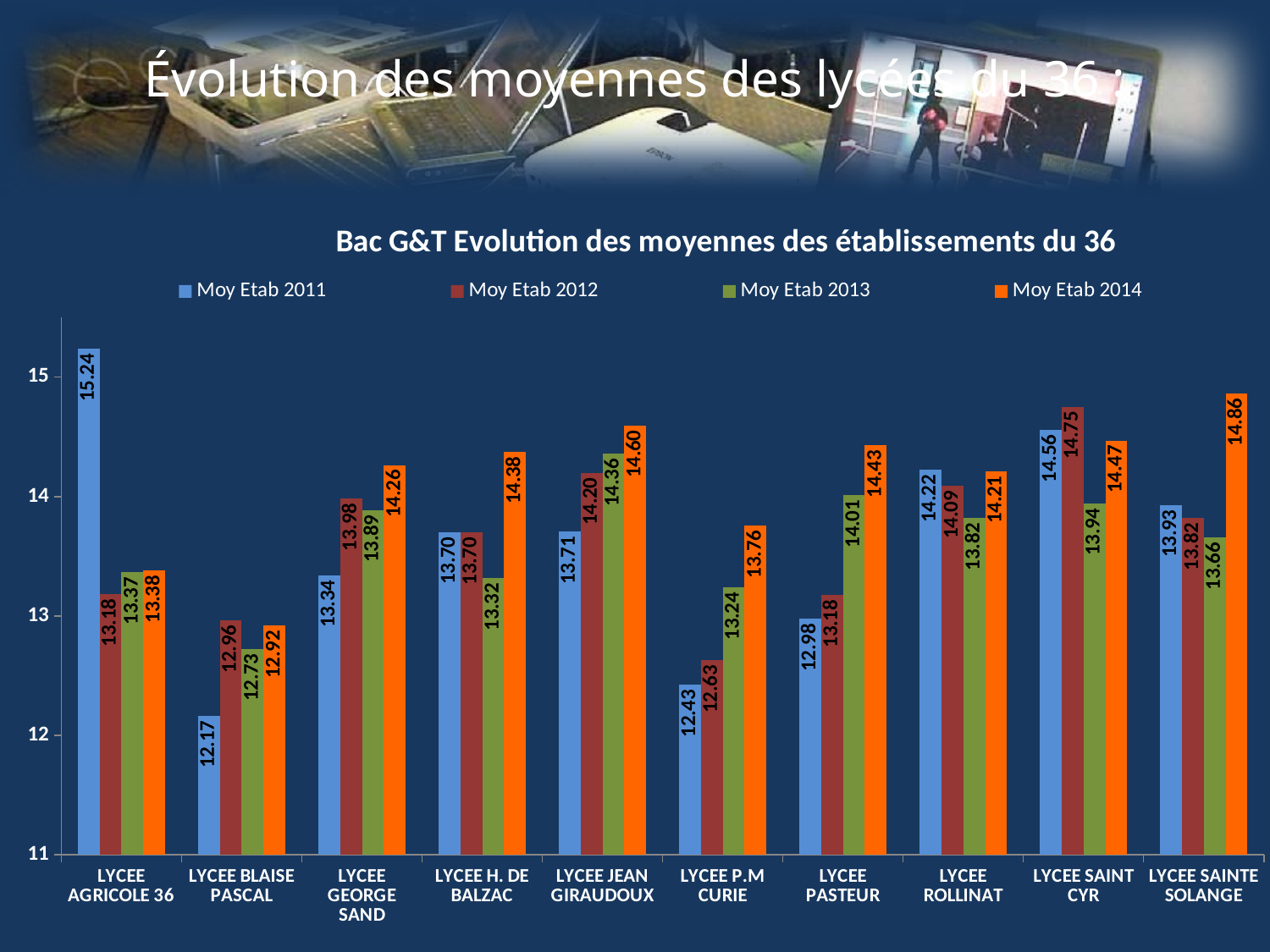
Is the Moy Etab 2014 value for LYCEE JEAN GIRAUDOUX greater or less than 14? greater What is the difference between the Moy Etab 2014 and Moy Etab 2011 values for LYCEE P.M CURIE? 1.33 How many series does the legend list? 4 Which is larger for LYCEE ROLLINAT: the Moy Etab 2011 value or the Moy Etab 2013 value? Moy Etab 2011 What is the Moy Etab 2014 value for LYCEE SAINTE SOLANGE? 14.86 Which lycée has the highest Moy Etab 2012 value? LYCEE SAINT CYR What kind of chart is shown on the slide? Bar chart What is the Moy Etab 2013 value for LYCEE PASTEUR? 14.01 Which lycée has the lowest Moy Etab 2011 value? LYCEE BLAISE PASCAL Do the values for LYCEE P.M CURIE rise or fall from Moy Etab 2011 to Moy Etab 2014? Rise What is the Moy Etab 2011 value for LYCEE AGRICOLE 36? 15.24 How many lycées are shown on the x axis of the chart? 10